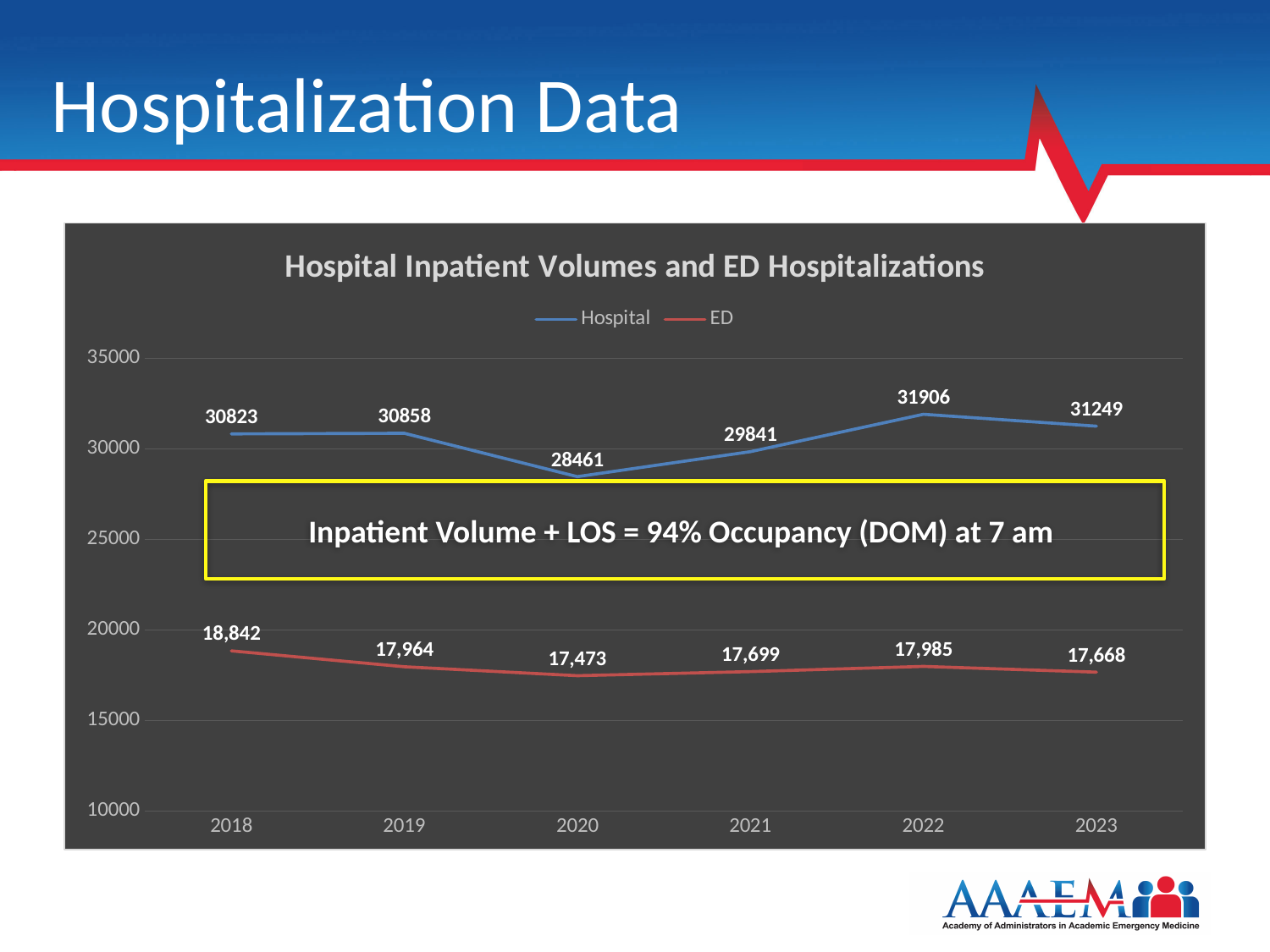
What is the Hospital value for 2020? 28461 Is the Hospital value for 2023 greater or less than 30000? greater What kind of chart is shown? line chart In which year is the Hospital series highest? 2022 How many years are shown on the x axis? 6 What is the ED value for 2018? 18,842 What is the difference between the Hospital values for 2022 and 2020? 3445 What is the title of the chart? Hospital Inpatient Volumes and ED Hospitalizations What is the Hospital value for 2022? 31906 In which year is the ED series lowest? 2020 Which is larger, the ED value for 2019 or the ED value for 2022? 2022 How many series does the legend list? 2